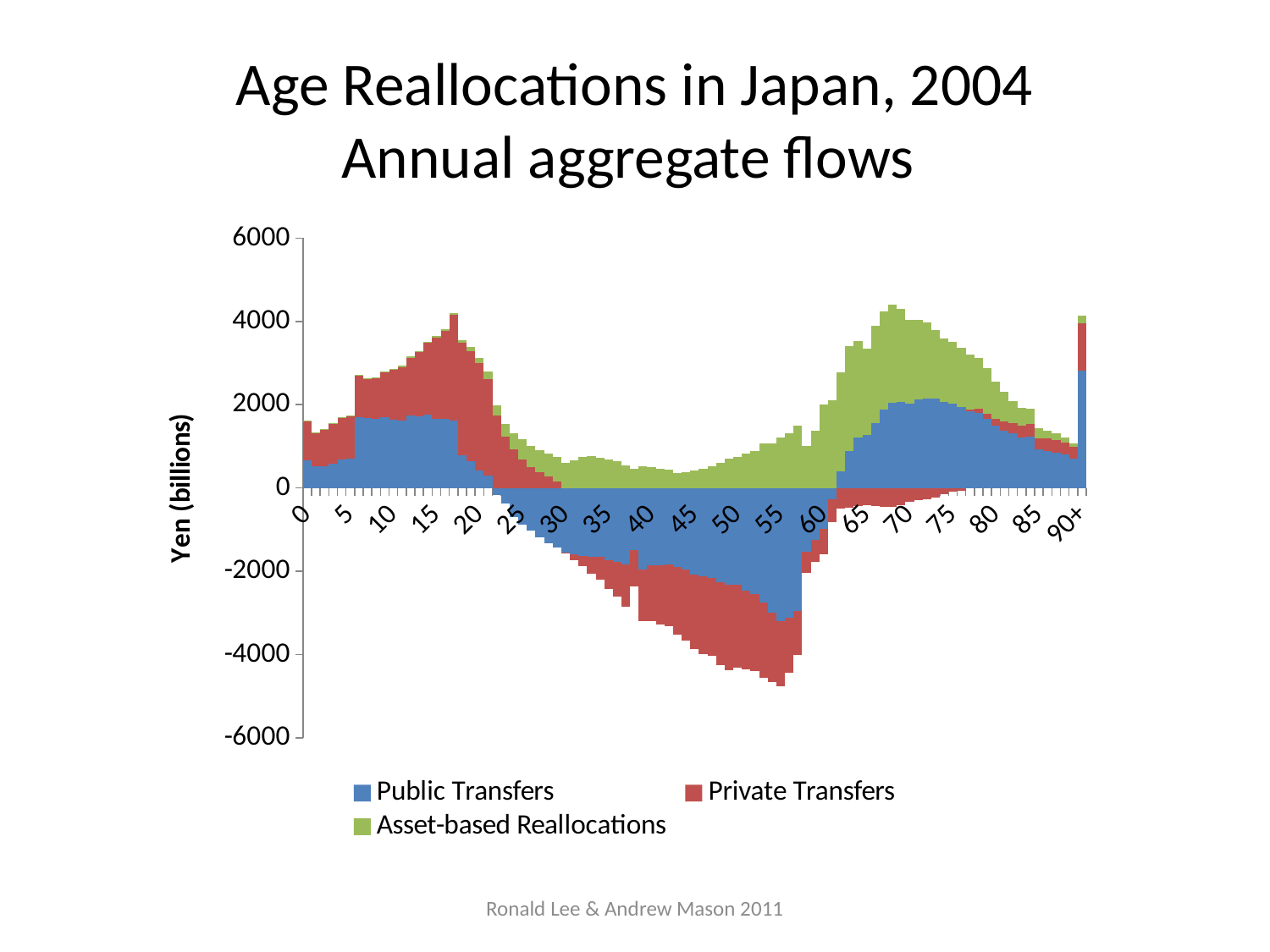
What is the label on the vertical axis? Yen (billions) Do the Public Transfers values rise or fall from age 20 to age 30? Fall Is the value for Public Transfers at age 55 greater or less than -2000? less What kind of chart is shown on the slide? Stacked bar chart Is the total stacked value at age 70 greater or less than 3000? greater Is the value for Public Transfers at age 70 greater or less than 1000? greater What is the highest value shown on the vertical axis? 6000 How many series does the legend list? 3 Which colour represents Asset-based Reallocations in the chart? Green Do the Public Transfers values rise or fall from age 60 to age 70? Rise Which is larger, the Public Transfers value at age 10 or at age 40? Age 10